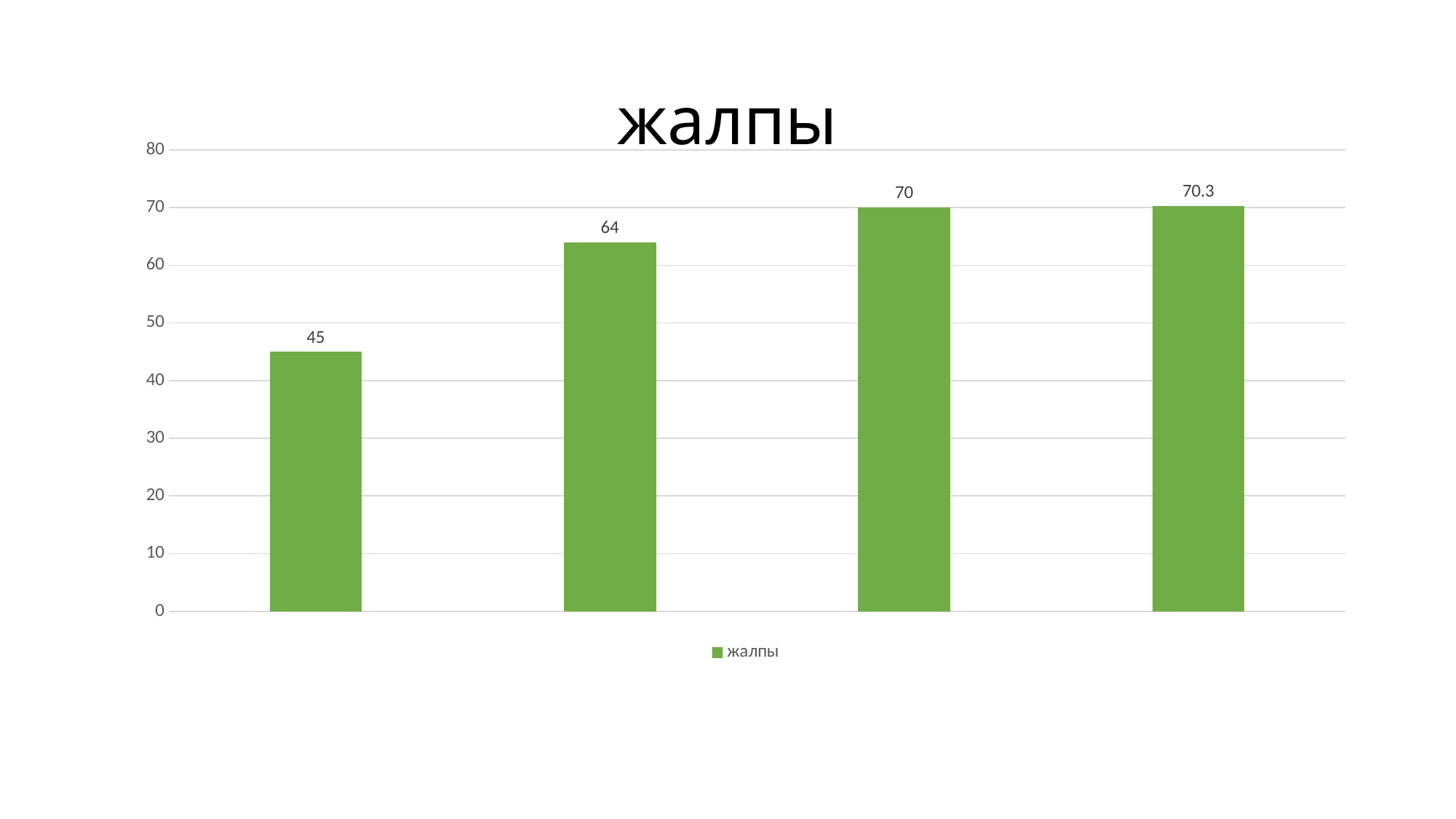
How many bars are plotted in the chart? 4 What is the value of the second bar from the left? 64 What is the value of the first (leftmost) bar? 45 Do the values rise or fall from left to right across the bars? rise Which bar has the highest value? the fourth (rightmost) bar Which bar has the lowest value? the first (leftmost) bar Which is larger, the value of the second bar or the value of the third bar? the third bar What is the value of the third bar from the left? 70 What kind of chart is shown on the slide? bar chart How many series does the legend list? 1 What is the difference between the second bar (64) and the first bar (45)? 19 What is the value of the fourth (rightmost) bar? 70.3